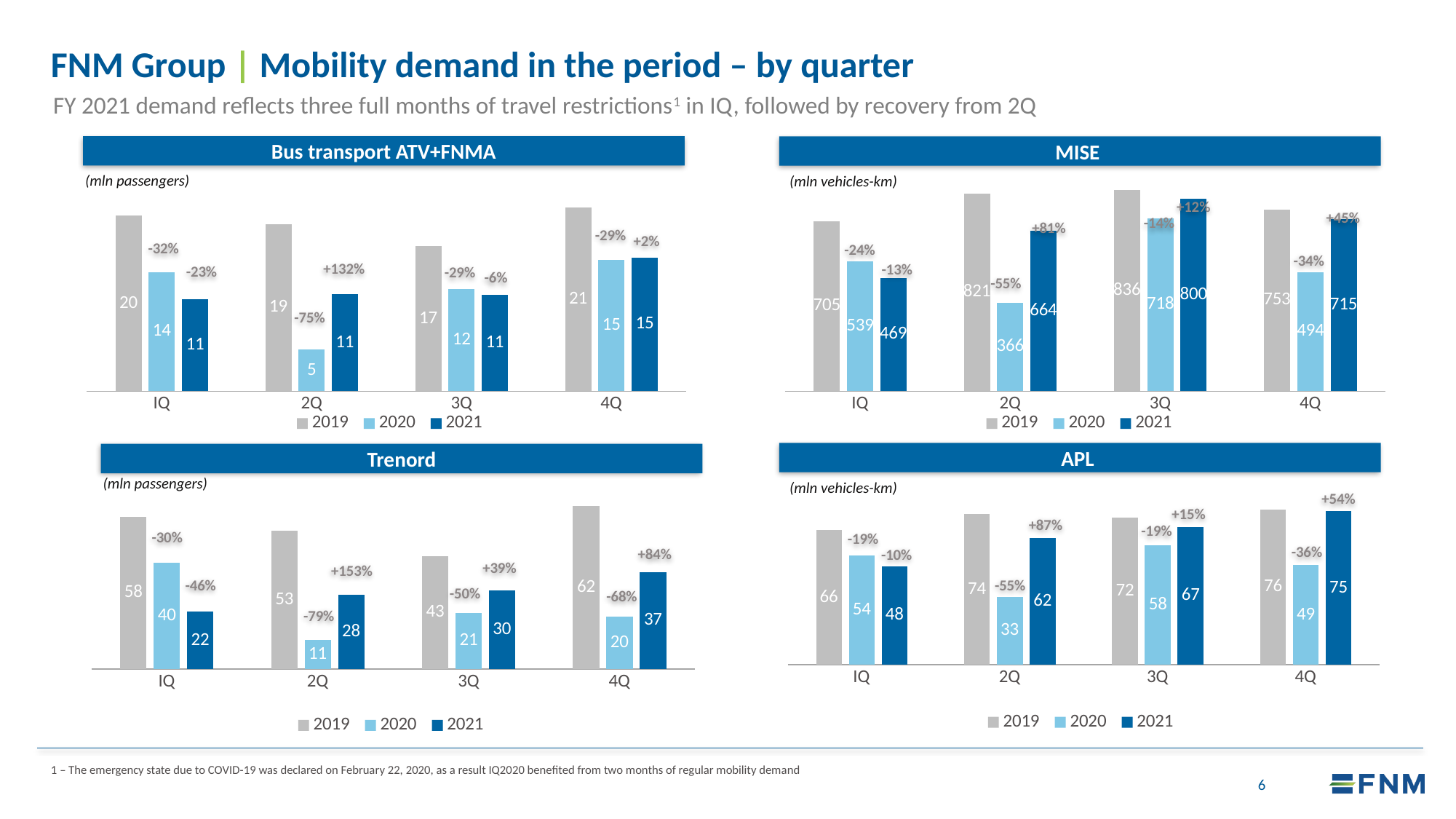
In the MISE chart, what is the 2020 value for 3Q? 718 How many series does the legend of the Trenord chart list? 3 What kind of chart is the MISE chart? Bar chart In the Bus transport ATV+FNMA chart, which is larger for 3Q: the 2020 value or the 2021 value? 2020 In the APL chart, what is the difference between the 2019 and 2021 values for 2Q? 12 In the Bus transport ATV+FNMA chart, what is the 2021 value for 2Q? 11 What unit is shown under the title of the APL chart? mln vehicles-km In the Trenord chart, which quarter has the lowest 2020 value? 2Q In the Trenord chart, what is the 2019 value for 4Q? 62 In the APL chart, what is the 2021 value for 4Q? 75 In the MISE chart, which quarter has the highest 2021 value? 3Q How many quarters are shown on the x axis of the APL chart? 4